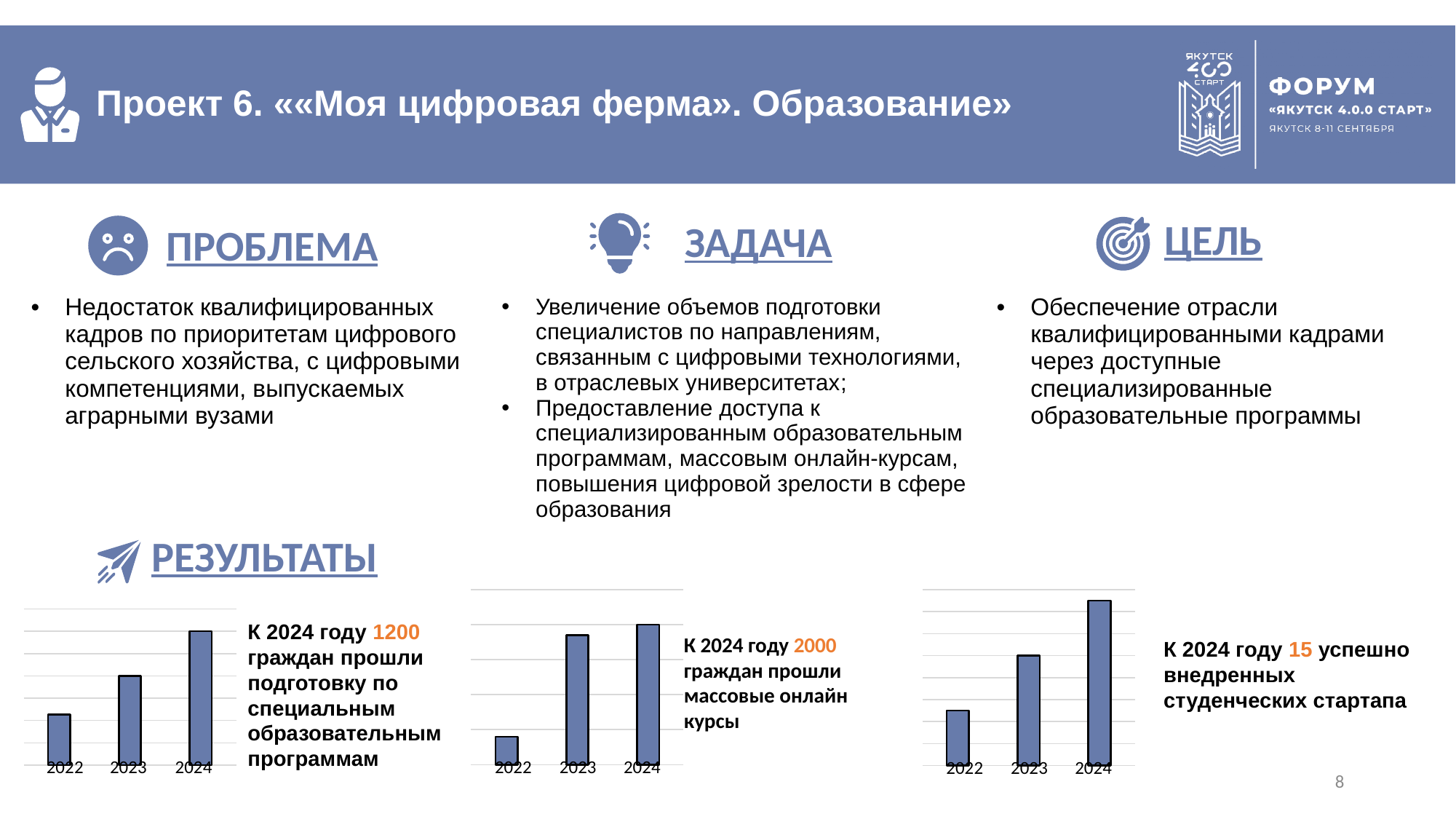
In the middle bar chart, which is larger, the bar for 2022 or the bar for 2023? 2023 In the left bar chart, which year has the lowest bar? 2022 In the right bar chart, which year has the highest bar? 2024 What are the category labels on the x axis of the right bar chart? 2022, 2023, 2024 What kind of chart is the left chart at the bottom of the slide? bar chart In the middle bar chart, do the values rise or fall along the x axis? rise How many bar charts are shown on the slide? 3 How many categories does the left bar chart show? 3 In the middle bar chart, which year has the lowest bar? 2022 In the left bar chart, which year has the highest bar? 2024 In the left bar chart, do the values rise or fall from 2022 to 2024? rise In the right bar chart, which is larger, the bar for 2022 or the bar for 2024? 2024